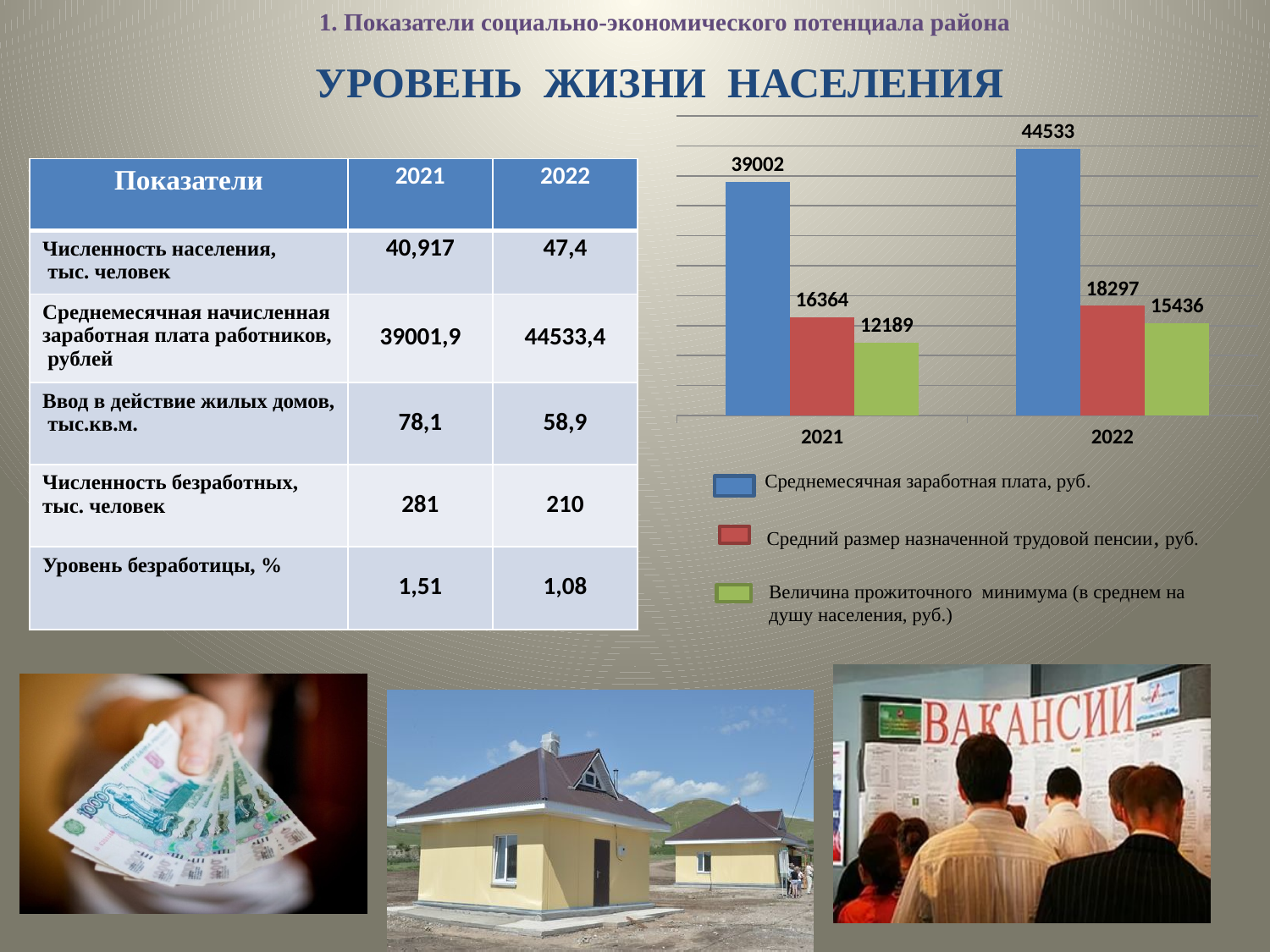
What is the average monthly wage (Среднемесячная заработная плата) shown in the chart for 2022? 44533 What is the subsistence minimum (Величина прожиточного минимума) in the chart for 2022? 15436 What is the average assigned labour pension (Средний размер назначенной трудовой пенсии) in the chart for 2021? 16364 What is the average monthly wage (Среднемесячная заработная плата) shown in the chart for 2021? 39002 How many years (categories) are shown on the x axis of the chart? 2 What is the difference between the average pension and the subsistence minimum in the chart for 2022? 2861 Which year has the higher subsistence minimum (Величина прожиточного минимума) in the chart, 2021 or 2022? 2022 How many series does the chart legend list? 3 What type of chart is shown on the slide? bar chart Which colour represents Среднемесячная заработная плата in the chart legend? blue Which series has the lowest value in the chart for 2021? Величина прожиточного минимума By how much did the average monthly wage in the chart increase from 2021 to 2022? 5531